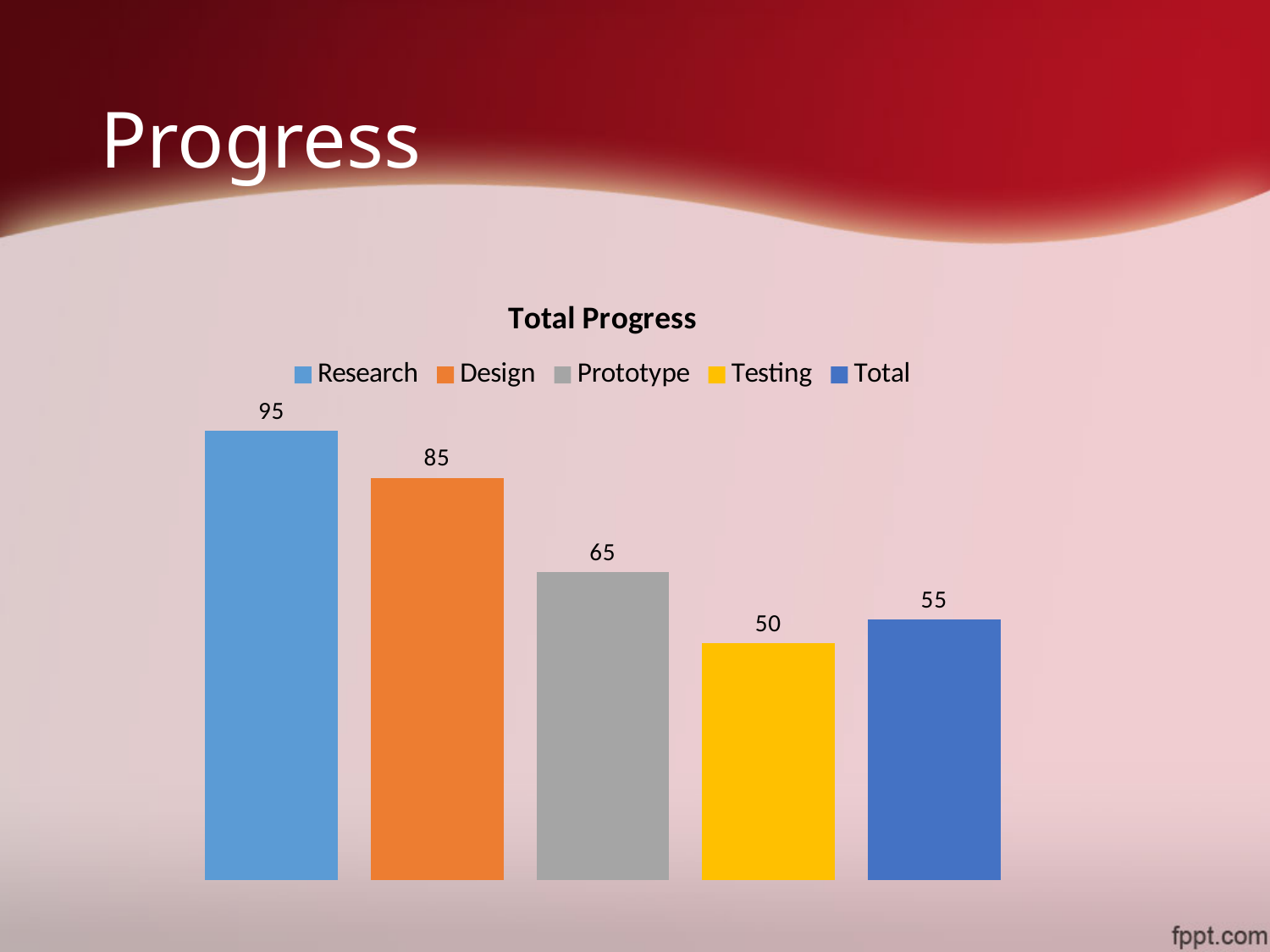
What is the value for Testing? 50 What kind of chart is shown on the slide? Bar chart Which series has the lowest value? Testing What is the value for Prototype? 65 How many series does the legend list? 5 What is the difference between the values for Research and Design? 10 What is the value for Design? 85 Which is larger, the value for Prototype or the value for Total? Prototype Which series has the highest value? Research What is the value for Total? 55 What is the value for Research? 95 What is the title of the chart? Total Progress